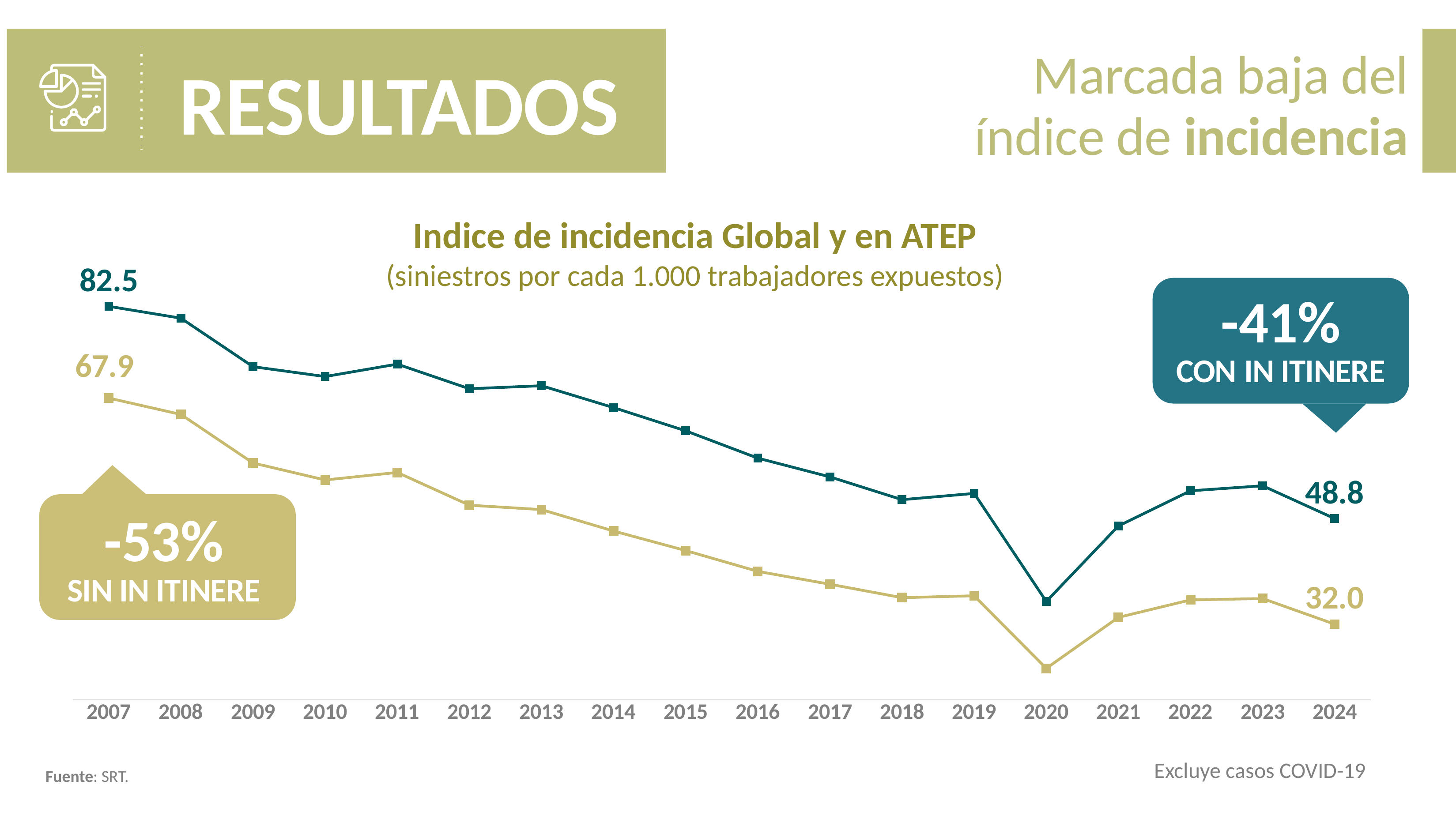
What is the value of the lower (gold) line in 2007? 67.9 By how much did the lower (gold) line fall from 2007 to 2024? 35.9 How many years are shown on the x axis? 18 What is the difference between the two lines in 2007? 14.6 What is the value of the upper (dark teal) line in 2024? 48.8 What kind of chart is shown on the slide? line chart In which year do both lines reach their lowest point? 2020 What is the value of the lower (gold) line in 2024? 32.0 What is the difference between the two lines in 2024? 16.8 Do the values generally rise or fall from 2007 to 2024? fall What is the value of the upper (dark teal) line in 2007? 82.5